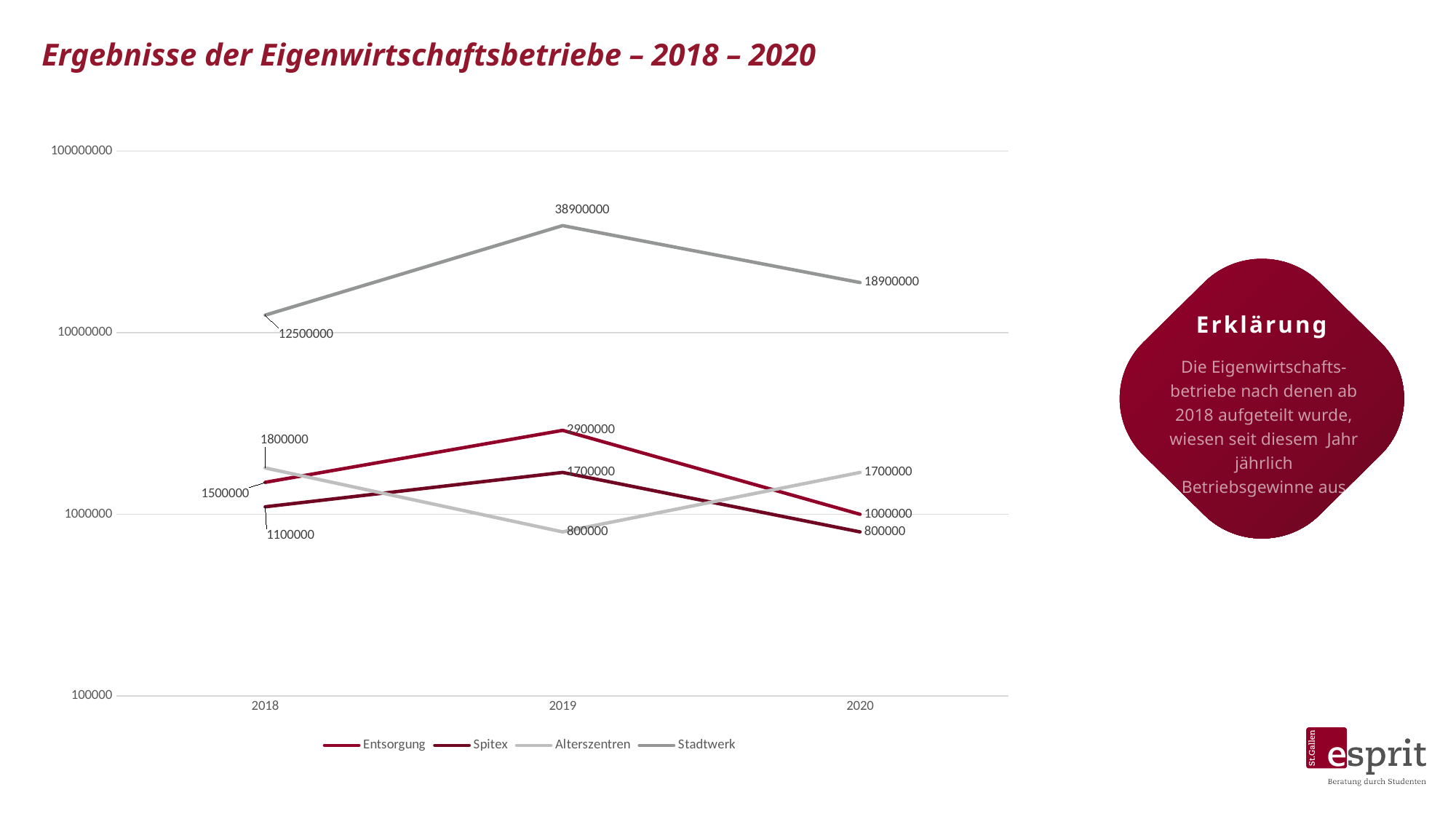
Which series has the lowest value in 2019? Alterszentren Which is larger in 2018, the value for Entsorgung or the value for Spitex? Entsorgung What kind of chart is shown on the slide? line chart Does the Stadtwerk line rise or fall from 2019 to 2020? fall What is the value for Stadtwerk in 2018? 12500000 What is the difference between the Stadtwerk values for 2019 and 2020? 20000000 Which series has the highest value in 2020? Stadtwerk How many years are plotted on the x axis? 3 How many series does the legend list? 4 What is the value for Entsorgung in 2019? 2900000 What is the value for Stadtwerk in 2019? 38900000 What is the value for Alterszentren in 2020? 1700000